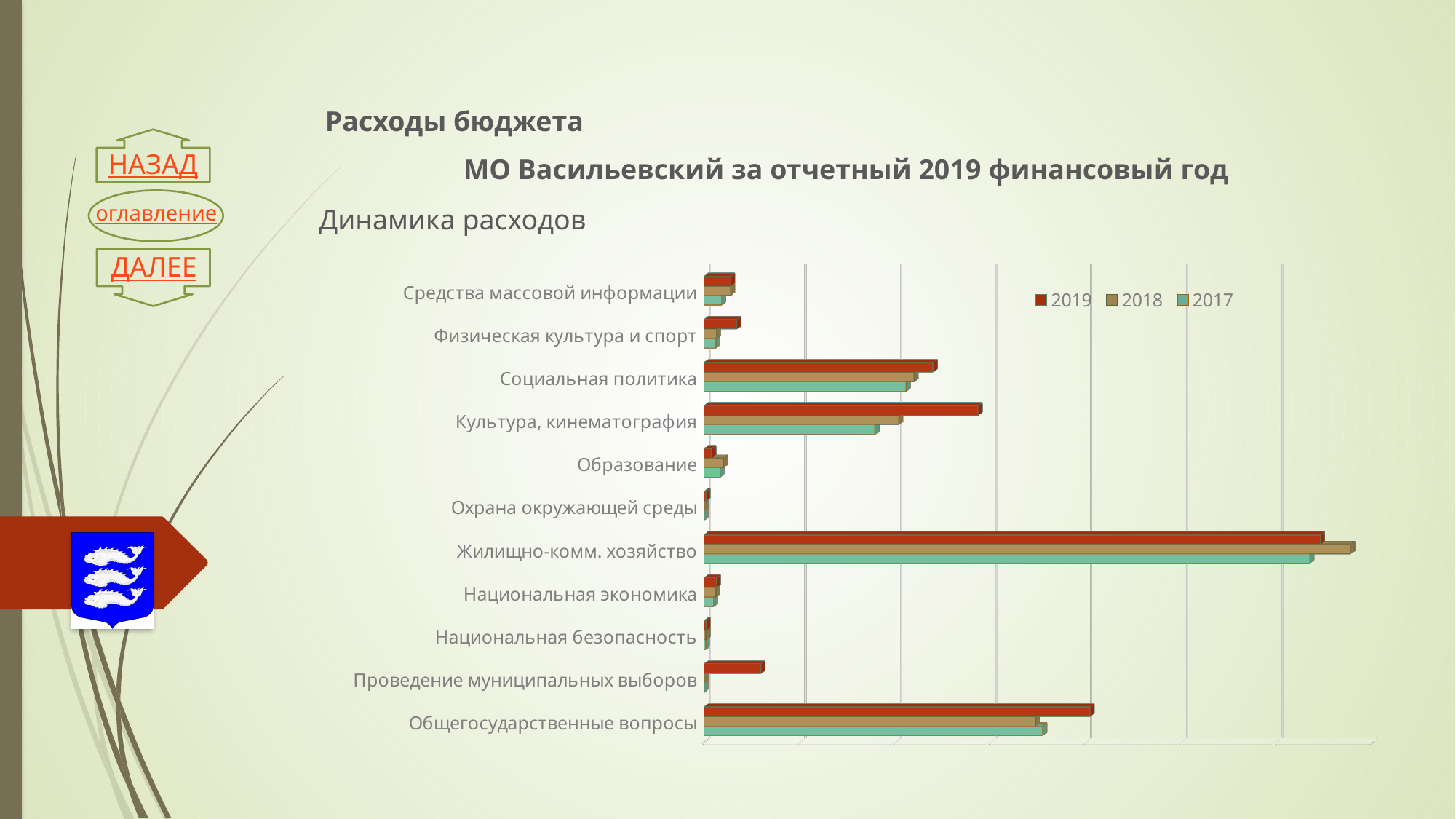
What is the title of the chart? Динамика расходов How many series does the legend list? 3 For 2019, which is larger: Культура, кинематография or Социальная политика? Культура, кинематография Which category has the largest bar for 2019? Жилищно-комм. хозяйство Which years are listed in the chart legend? 2019, 2018, 2017 Did spending on Культура, кинематография rise or fall from 2017 to 2019? rise For Проведение муниципальных выборов, which year has a clearly visible bar? 2019 For Жилищно-комм. хозяйство, which year has the larger bar: 2018 or 2019? 2018 How many expenditure categories are shown on the chart? 11 What kind of chart is shown on the slide? bar chart Which category has the largest bar for 2017? Жилищно-комм. хозяйство